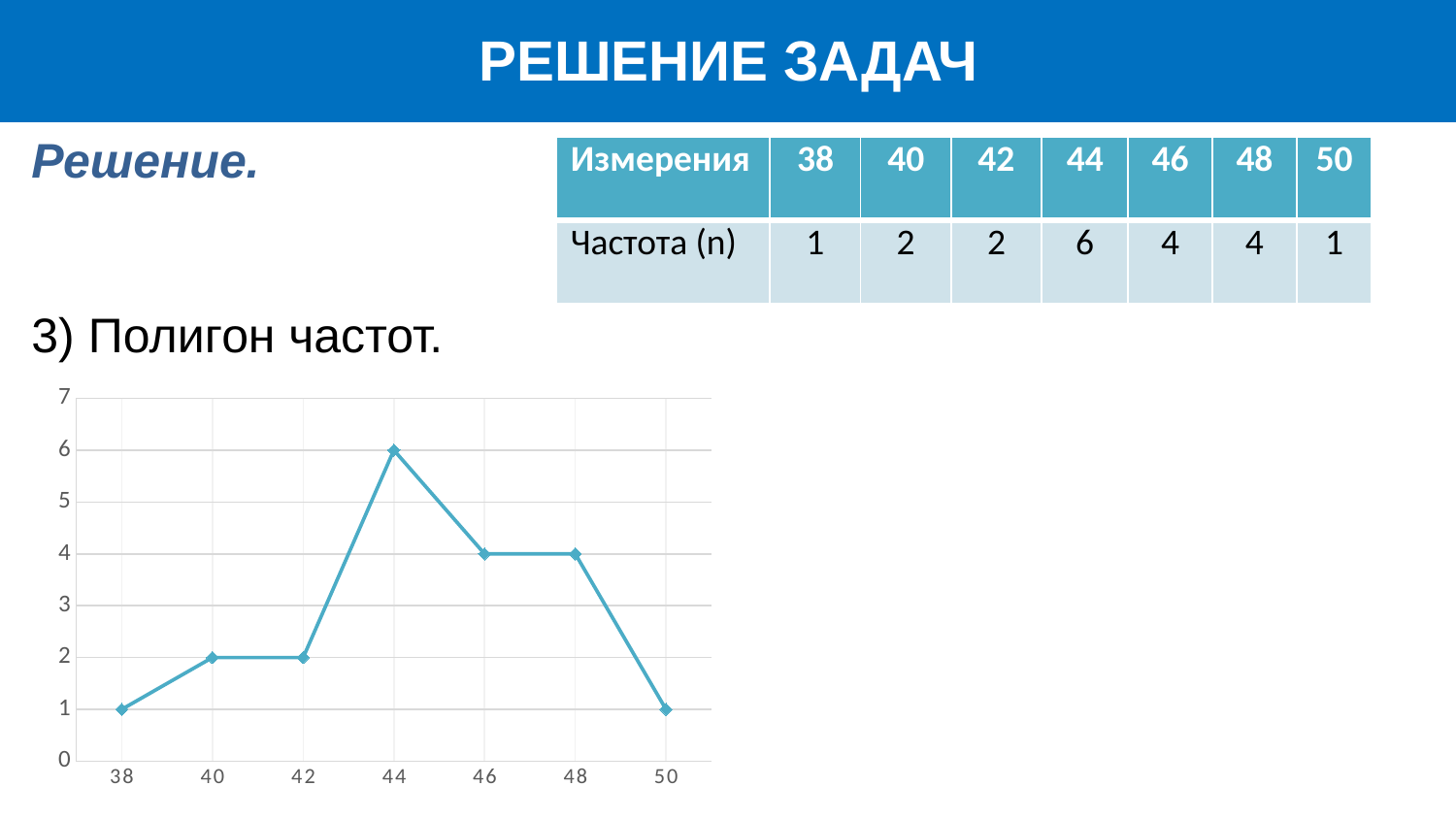
What type of chart is shown on the slide? line chart What is the maximum value shown on the vertical axis of the chart? 7 How many data points are plotted on the frequency polygon? 7 What is the difference between the frequency at 44 and the frequency at 48? 2 What is the frequency plotted for the measurement 38? 1 What is the frequency plotted for the measurement 44? 6 Does the frequency rise or fall between measurements 44 and 50? fall Which has a higher frequency: measurement 40 or measurement 46? 46 What is the frequency plotted for the measurement 46? 4 What is the difference between the frequency at 42 and the frequency at 50? 1 Which measurement values share the lowest frequency on the chart? 38 and 50 Which measurement value has the highest frequency on the chart? 44